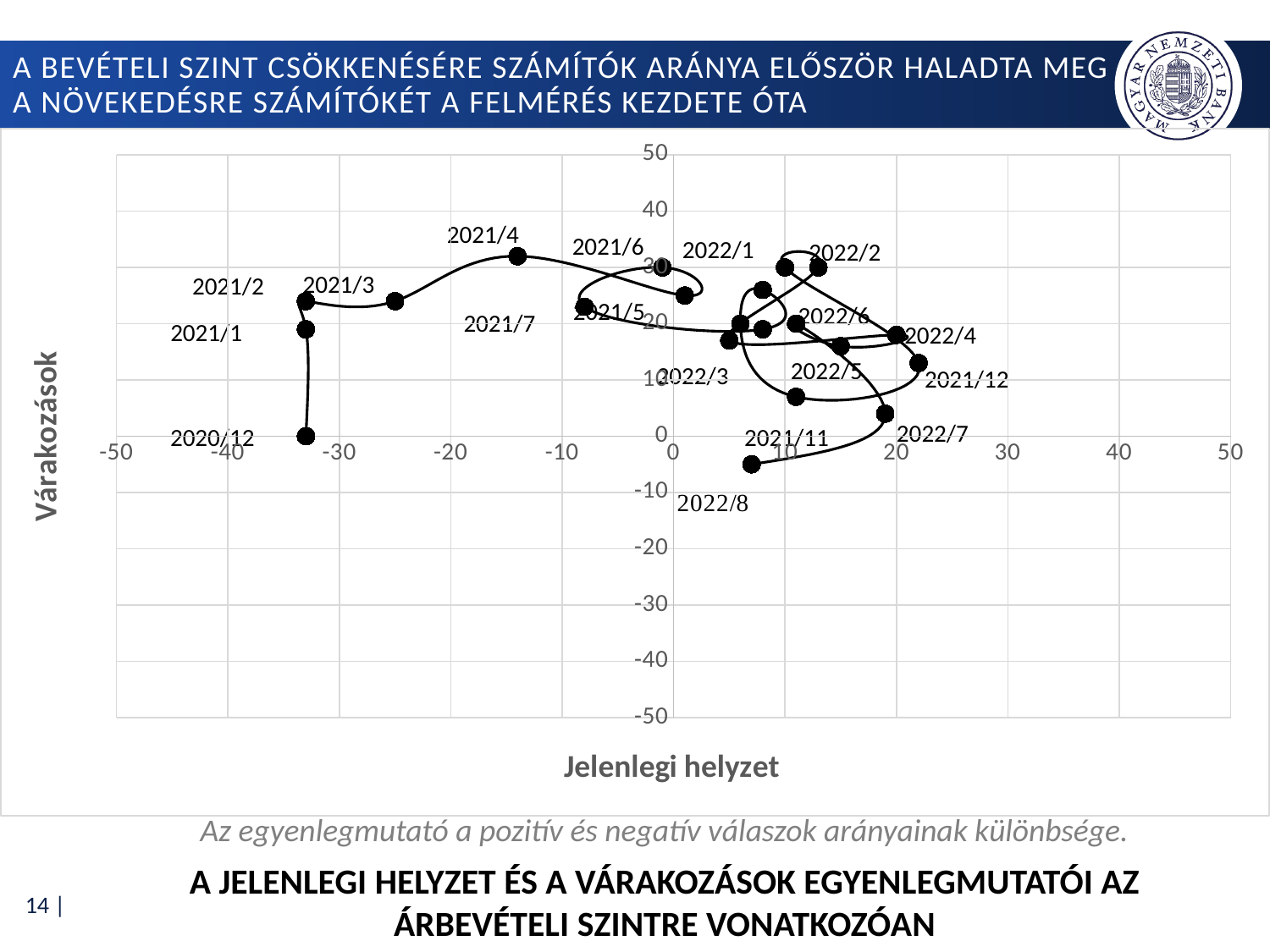
Is the Várakozások value for 2022/7 greater or less than 10? less Is the Várakozások value for 2021/4 greater or less than 20? greater Is the Jelenlegi helyzet value for 2020/12 greater or less than -30? less What kind of chart is shown on the slide? Scatter chart What is the title of the vertical axis of the chart? Várakozások What is the title of the horizontal axis of the chart? Jelenlegi helyzet Which point has the higher Jelenlegi helyzet value, 2020/12 or 2022/7? 2022/7 Which point has the higher Várakozások value, 2021/4 or 2022/8? 2021/4 Which labeled point has the lowest value on the Várakozások (vertical) axis? 2022/8